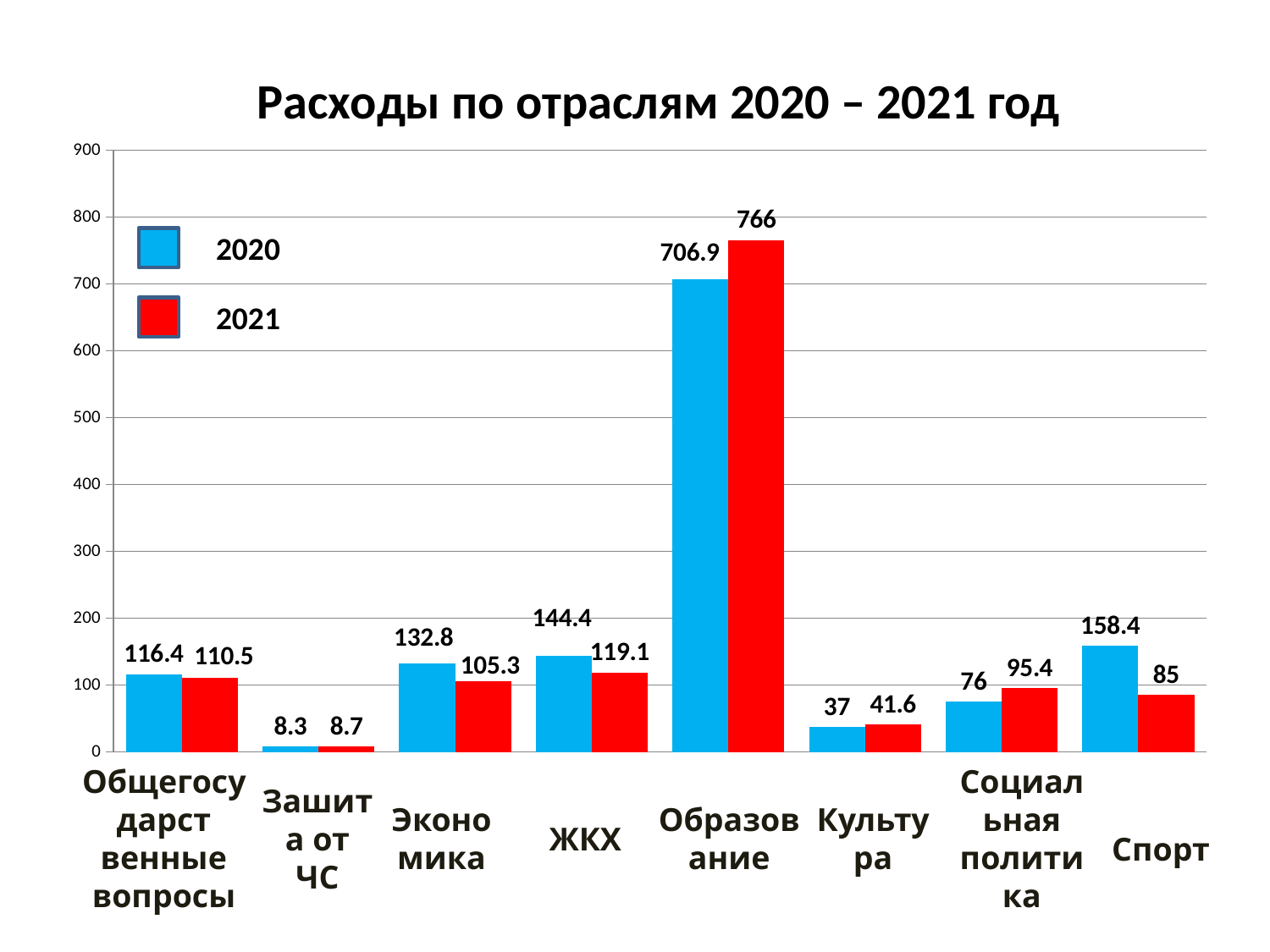
What is the title of the chart? Расходы по отраслям 2020 – 2021 год What kind of chart is shown? bar chart What is the 2020 value for Образование? 706.9 Which category has the highest 2021 value? Образование Which category has the lowest 2020 value? Зашита от ЧС What is the 2021 value for Спорт? 85 Is the 2020 value for Спорт greater or less than 100? greater Which is larger for ЖКХ, the 2020 value or the 2021 value? 2020 What is the 2021 value for Социальная политика? 95.4 How many series does the legend list? 2 What is the difference between the 2021 and 2020 values for Образование? 59.1 How many categories are shown on the x axis? 8